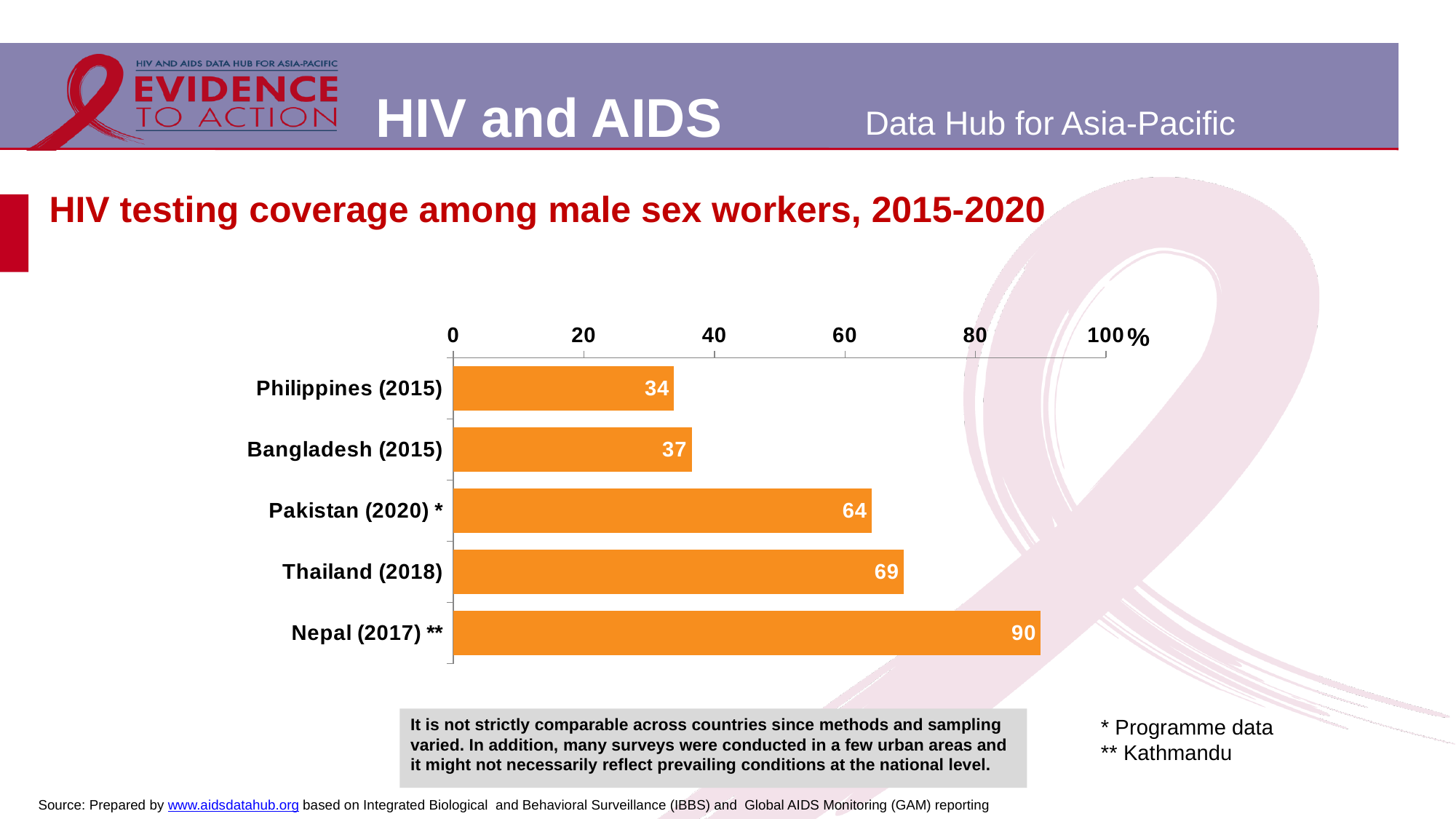
How many countries are shown in the chart? 5 Which country has the lowest HIV testing coverage among male sex workers? Philippines (2015) What is the HIV testing coverage value for Thailand (2018)? 69 What is the title of the chart? HIV testing coverage among male sex workers, 2015-2020 Which has a higher value, Thailand (2018) or Pakistan (2020) *? Thailand (2018) What is the difference between the values for Bangladesh (2015) and Philippines (2015)? 3 Is the value for Bangladesh (2015) greater or less than 40? less What is the difference between the values for Nepal (2017) ** and Pakistan (2020) *? 26 Which country has the highest HIV testing coverage among male sex workers? Nepal (2017) ** What is the HIV testing coverage value for Philippines (2015)? 34 What is the value shown for Nepal (2017) **? 90 What type of chart is shown on the slide? bar chart